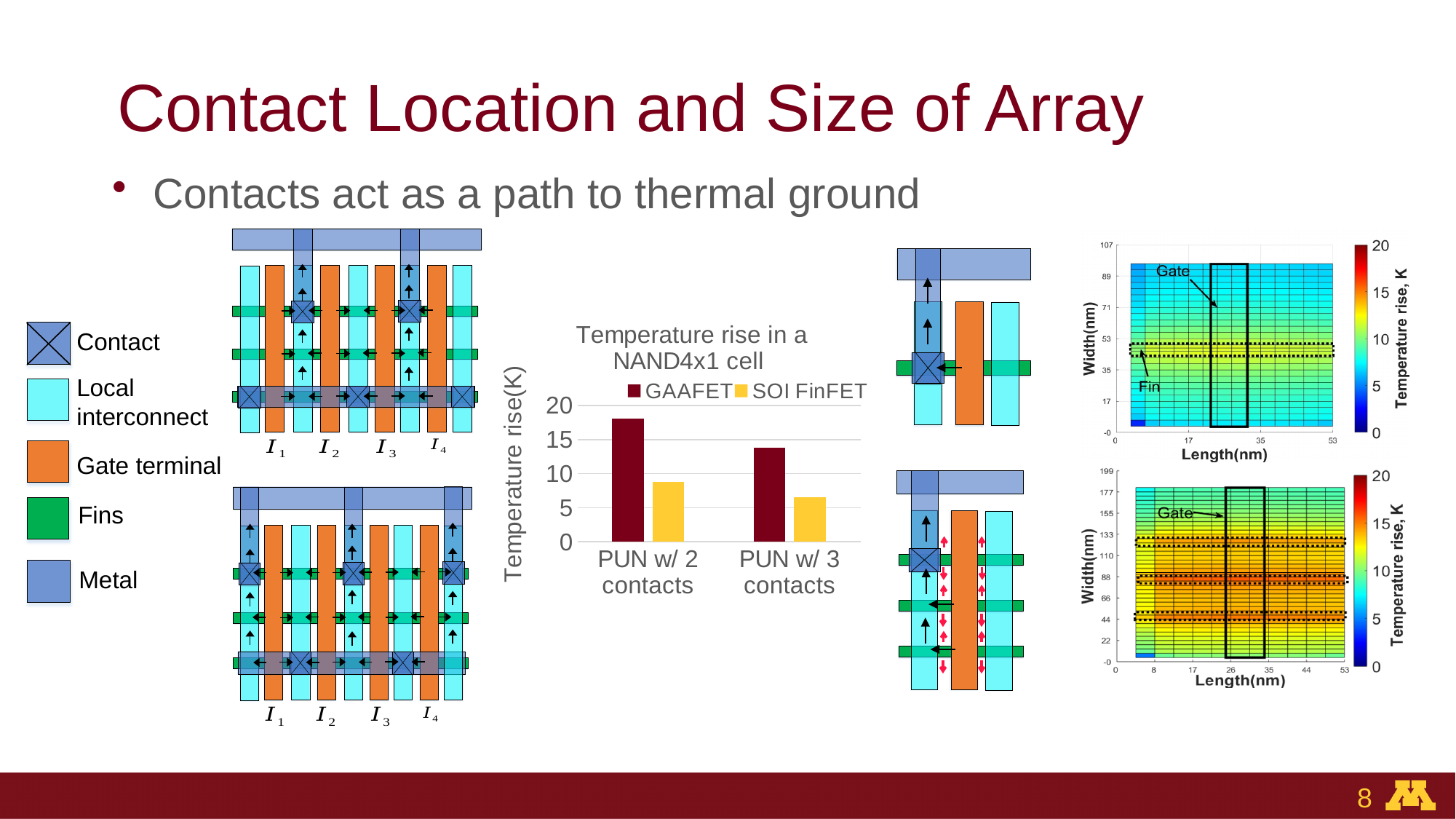
In the 'Temperature rise in a NAND4x1 cell' chart, is the GAAFET value for PUN w/ 3 contacts greater or less than 15? less What kind of chart is the 'Temperature rise in a NAND4x1 cell' chart? bar chart In the 'Temperature rise in a NAND4x1 cell' chart, which series and category has the highest bar? GAAFET, PUN w/ 2 contacts In the 'Temperature rise in a NAND4x1 cell' chart, for PUN w/ 2 contacts, which series has the larger value, GAAFET or SOI FinFET? GAAFET How many series does the legend of the 'Temperature rise in a NAND4x1 cell' chart list? 2 What is the y-axis label of the 'Temperature rise in a NAND4x1 cell' chart? Temperature rise(K) In the 'Temperature rise in a NAND4x1 cell' chart, does the GAAFET temperature rise increase or decrease from PUN w/ 2 contacts to PUN w/ 3 contacts? decrease How many categories are shown on the x axis of the 'Temperature rise in a NAND4x1 cell' chart? 2 In the 'Temperature rise in a NAND4x1 cell' chart, is the SOI FinFET value for PUN w/ 3 contacts greater or less than 5? greater In the 'Temperature rise in a NAND4x1 cell' chart, is the SOI FinFET value for PUN w/ 2 contacts greater or less than 10? less In the 'Temperature rise in a NAND4x1 cell' chart, which series and category has the lowest bar? SOI FinFET, PUN w/ 3 contacts